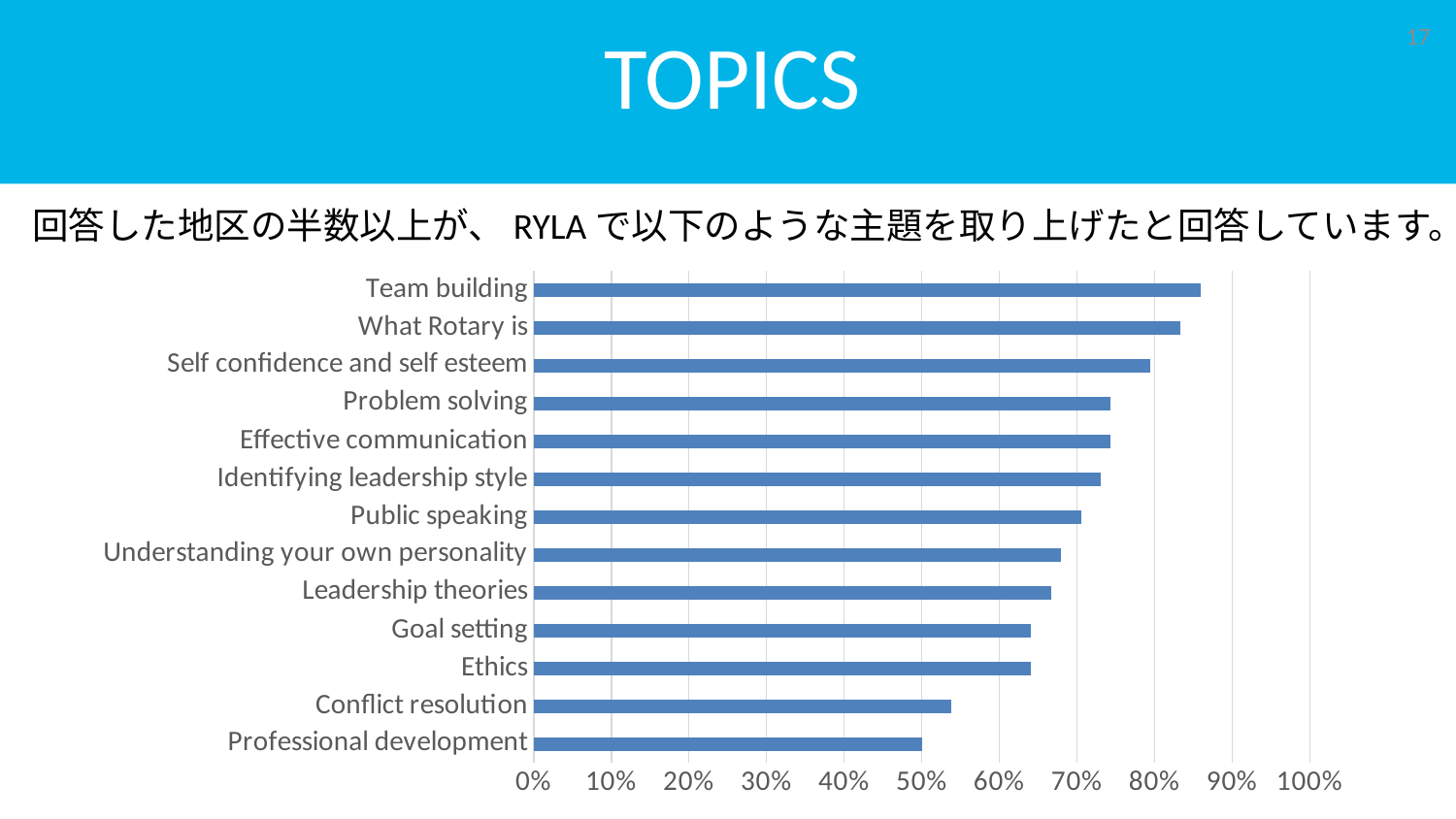
Is the value for Problem solving greater or less than 70%? greater Which has the larger value, Team building or Conflict resolution? Team building How many topics (categories) are plotted in the chart? 13 What colour are the bars in the chart? blue Is the value for Team building greater or less than 80%? greater Is the value for Conflict resolution greater or less than 60%? less Which topic has the lowest value in the chart? Professional development Which topic has the highest value in the chart? Team building Which has the larger value, What Rotary is or Goal setting? What Rotary is What kind of chart is shown on the slide? bar chart